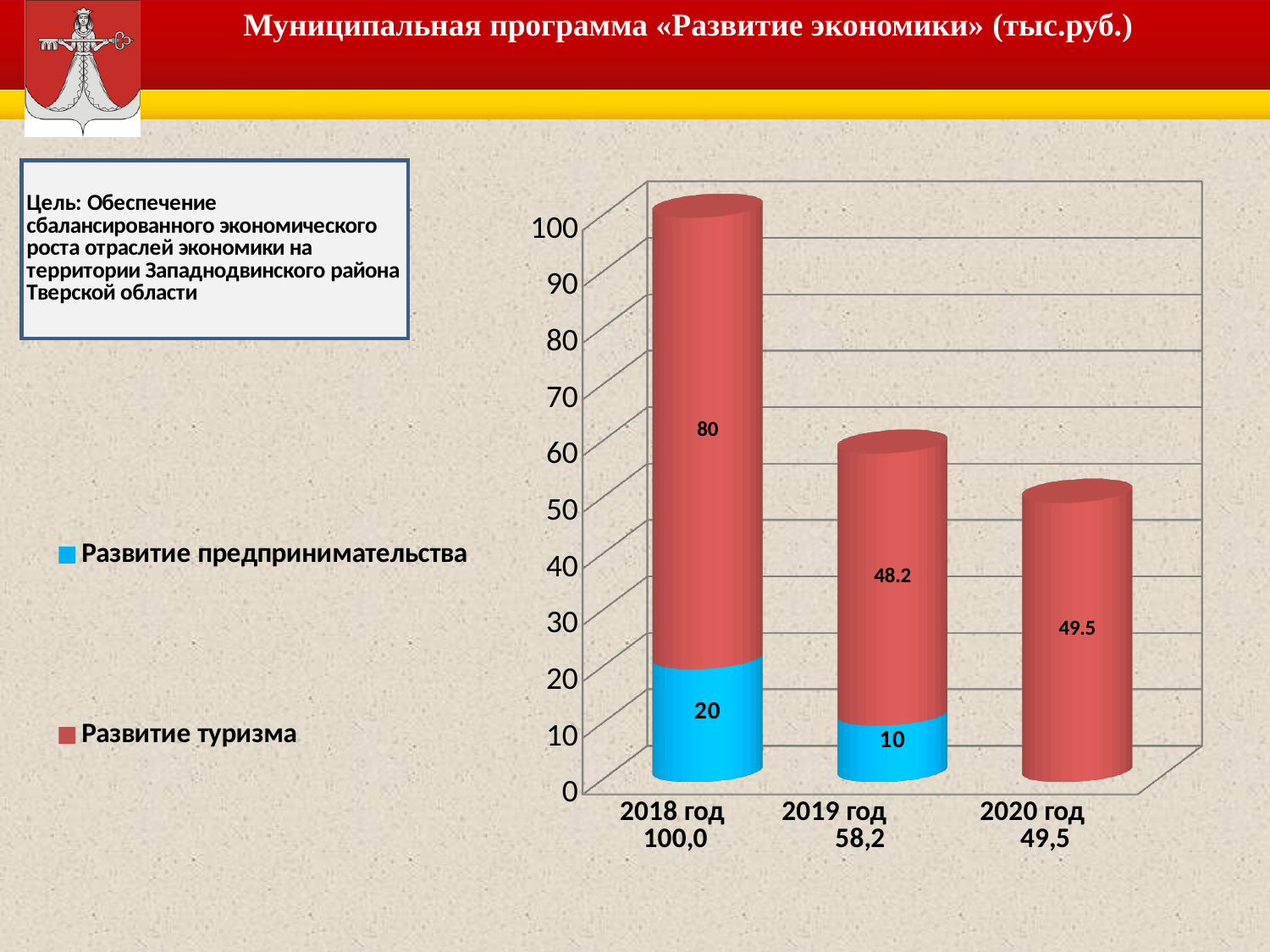
Which is larger: Развитие предпринимательства in 2018 год or in 2019 год? 2018 год In which year is the Развитие туризма value highest? 2018 год What is the value for Развитие предпринимательства in 2018 год? 20 What is the value for Развитие туризма in 2020 год? 49.5 What is the difference between the Развитие туризма values for 2018 год and 2019 год? 31.8 What is the value for Развитие туризма in 2018 год? 80 What is the value for Развитие предпринимательства in 2019 год? 10 What is the total of the stacked bar for 2019 год? 58.2 Do the total bar heights rise or fall from 2018 год to 2020 год? fall How many years are shown on the x axis? 3 In which year is the Развитие туризма value lowest? 2019 год How many series does the legend list? 2